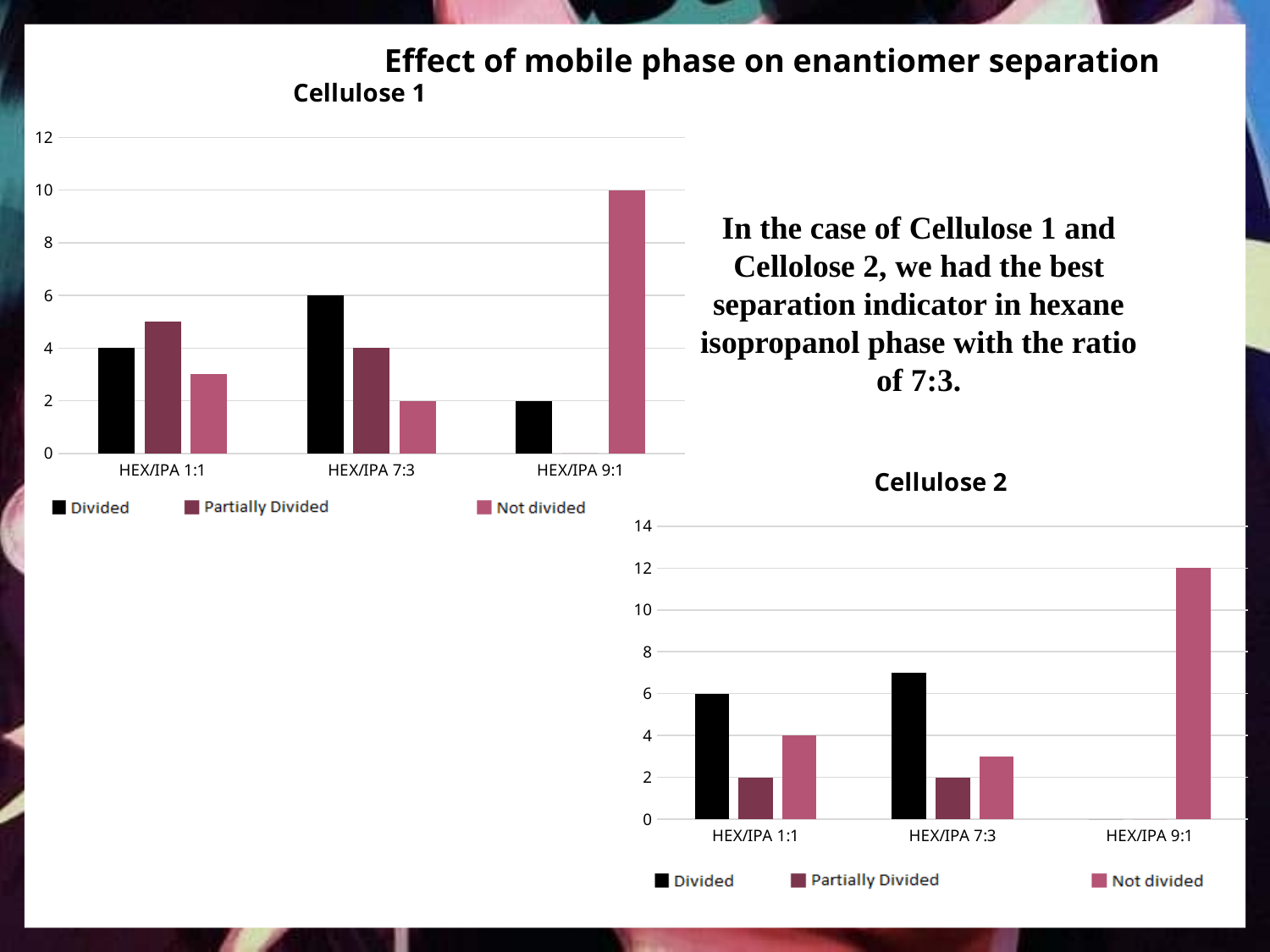
In the Cellulose 1 chart, which mobile phase has the highest Not divided value? HEX/IPA 9:1 In the Cellulose 2 chart, which mobile phase has the highest Divided value? HEX/IPA 7:3 In the Cellulose 2 chart, what is the value of the Not divided series for HEX/IPA 9:1? 12 In the Cellulose 1 chart, is the Partially Divided value for HEX/IPA 1:1 greater or less than 4? greater In the Cellulose 1 chart, what is the difference between the Divided values for HEX/IPA 7:3 and HEX/IPA 9:1? 4 In the Cellulose 1 chart, what is the value of the Divided series for HEX/IPA 7:3? 6 In the Cellulose 1 chart, what is the value of the Not divided series for HEX/IPA 9:1? 10 How many series does the legend of the Cellulose 2 chart list? 3 In the Cellulose 2 chart, what is the value of the Divided series for HEX/IPA 1:1? 6 In the Cellulose 2 chart, is the Divided value for HEX/IPA 7:3 greater or less than 6? greater In the Cellulose 1 chart, which is larger for HEX/IPA 7:3: the Divided value or the Not divided value? Divided What type of chart is the Cellulose 1 chart? Bar chart